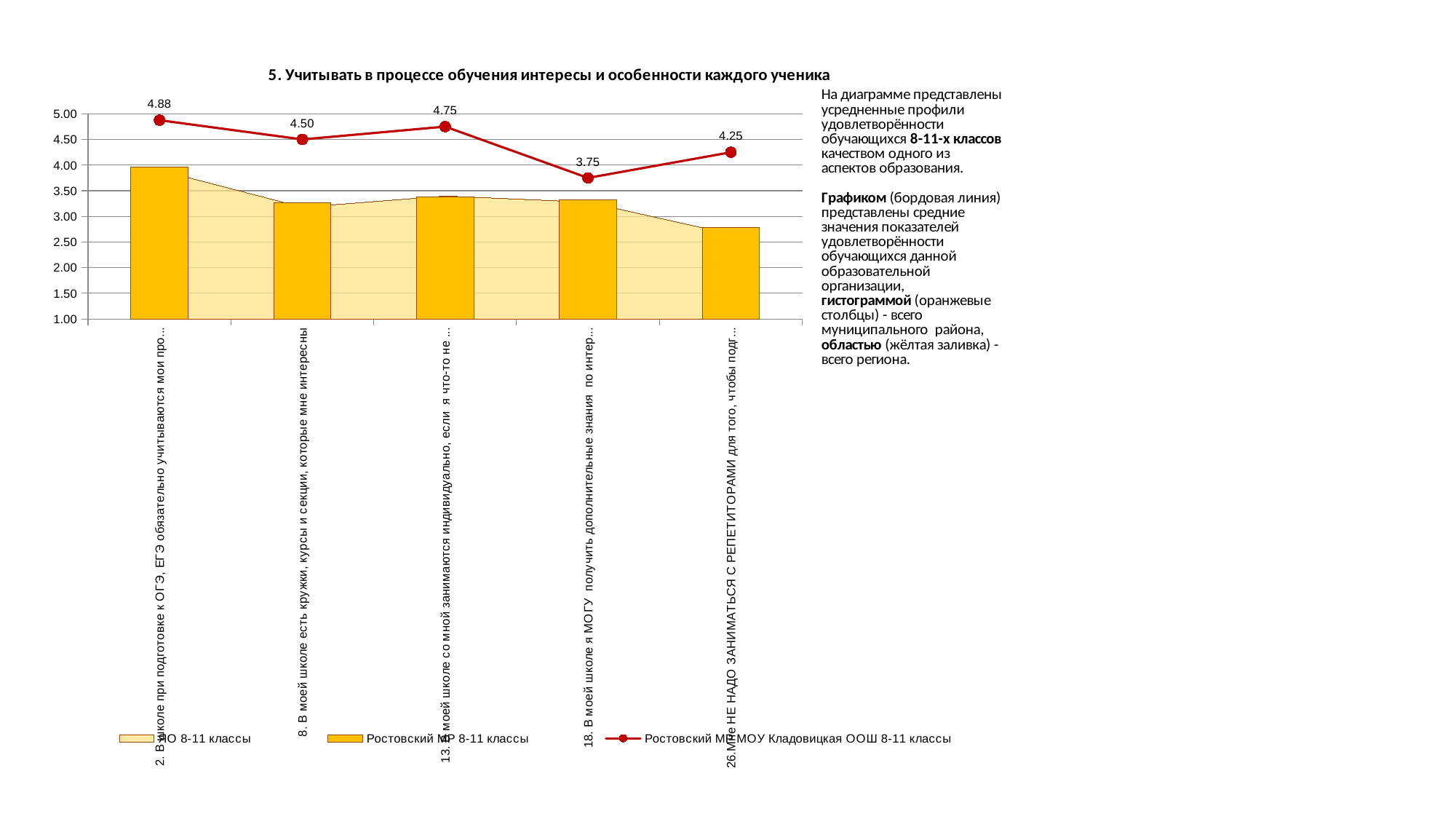
How many series does the chart legend list? 3 Is the orange bar (Ростовский МР 8-11 классы) for statement 2 greater or less than 3.50? greater For which statement does the red line (Кладовицкая ООШ) have its lowest value? Statement 18 (3.75) What is the value of the red line (Ростовский МР МОУ Кладовицкая ООШ 8-11 классы) for statement 8 (В моей школе есть кружки, курсы и секции, которые мне интересны)? 4.50 For which statement does the red line (Кладовицкая ООШ) reach its highest value? Statement 2 (4.88) How many statements (categories) are shown on the x axis of the chart? 5 What is the difference between the highest and lowest values of the red line (4.88 and 3.75)? 1.13 What is the value of the red line for statement 26 (Мне НЕ НАДО ЗАНИМАТЬСЯ С РЕПЕТИТОРАМИ...)? 4.25 Does the red line rise or fall between statement 13 and statement 18? falls What is the value of the red line for statement 18 (В моей школе я МОГУ получить дополнительные знания...)? 3.75 Is the orange bar (Ростовский МР 8-11 классы) for statement 26 greater or less than 3.00? less On the red line, which is larger: the value for statement 13 or the value for statement 26? Statement 13 (4.75)